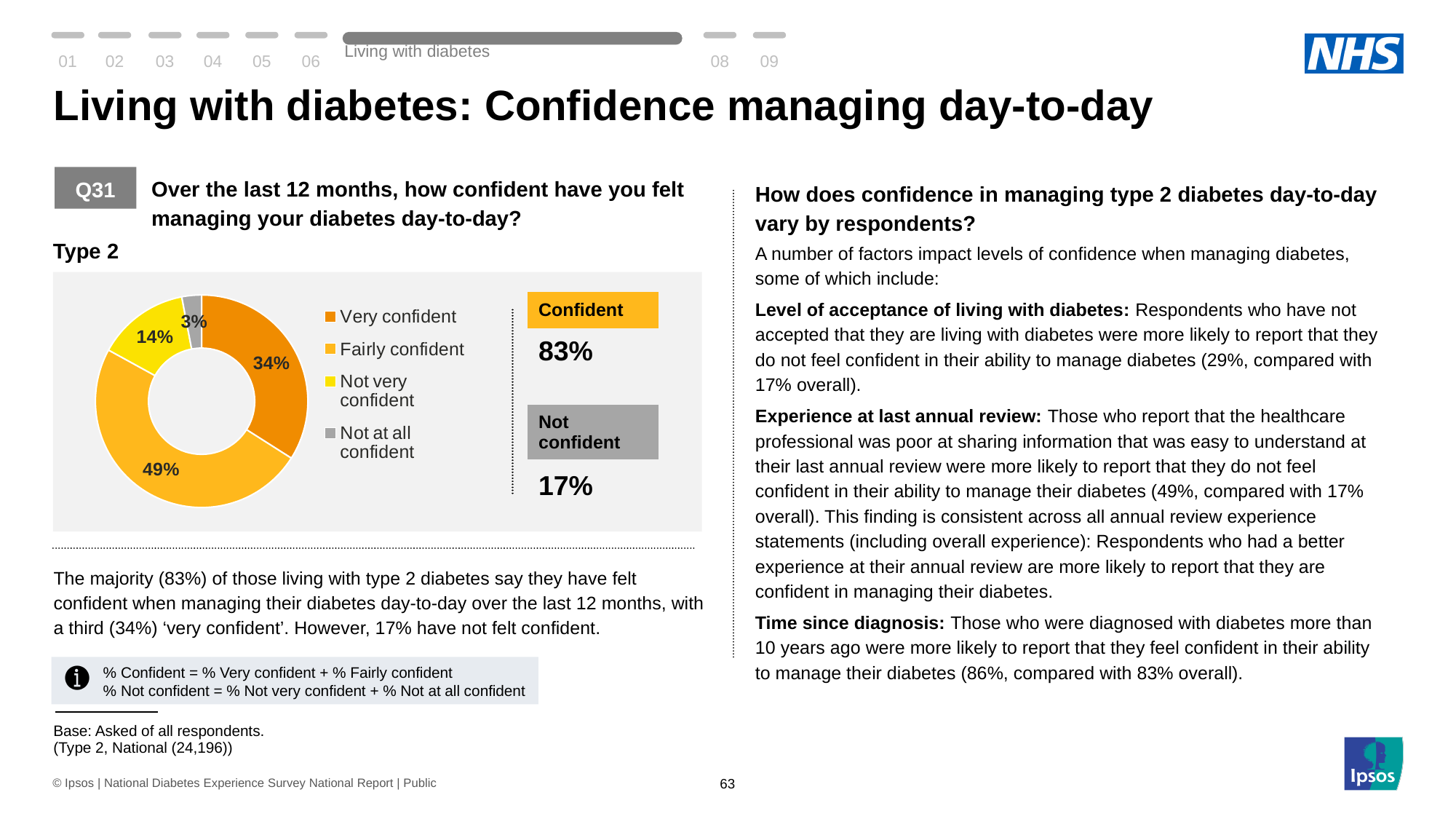
What is the difference in percentage points between 'Fairly confident' and 'Very confident'? 15 What is the combined percentage shown for 'Confident' next to the chart? 83% What percentage of respondents said they were 'Not at all confident'? 3% What percentage of respondents said they were 'Very confident'? 34% What percentage of respondents said they were 'Not very confident'? 14% What percentage of respondents said they were 'Fairly confident'? 49% Which category has the smallest share of the chart? Not at all confident Which category has the largest share of the chart? Fairly confident Which is larger, the share for 'Not very confident' or the share for 'Not at all confident'? Not very confident What kind of chart is shown on the slide? Doughnut (pie) chart How many categories does the chart show? 4 What colour is the 'Not at all confident' segment in the chart? Grey